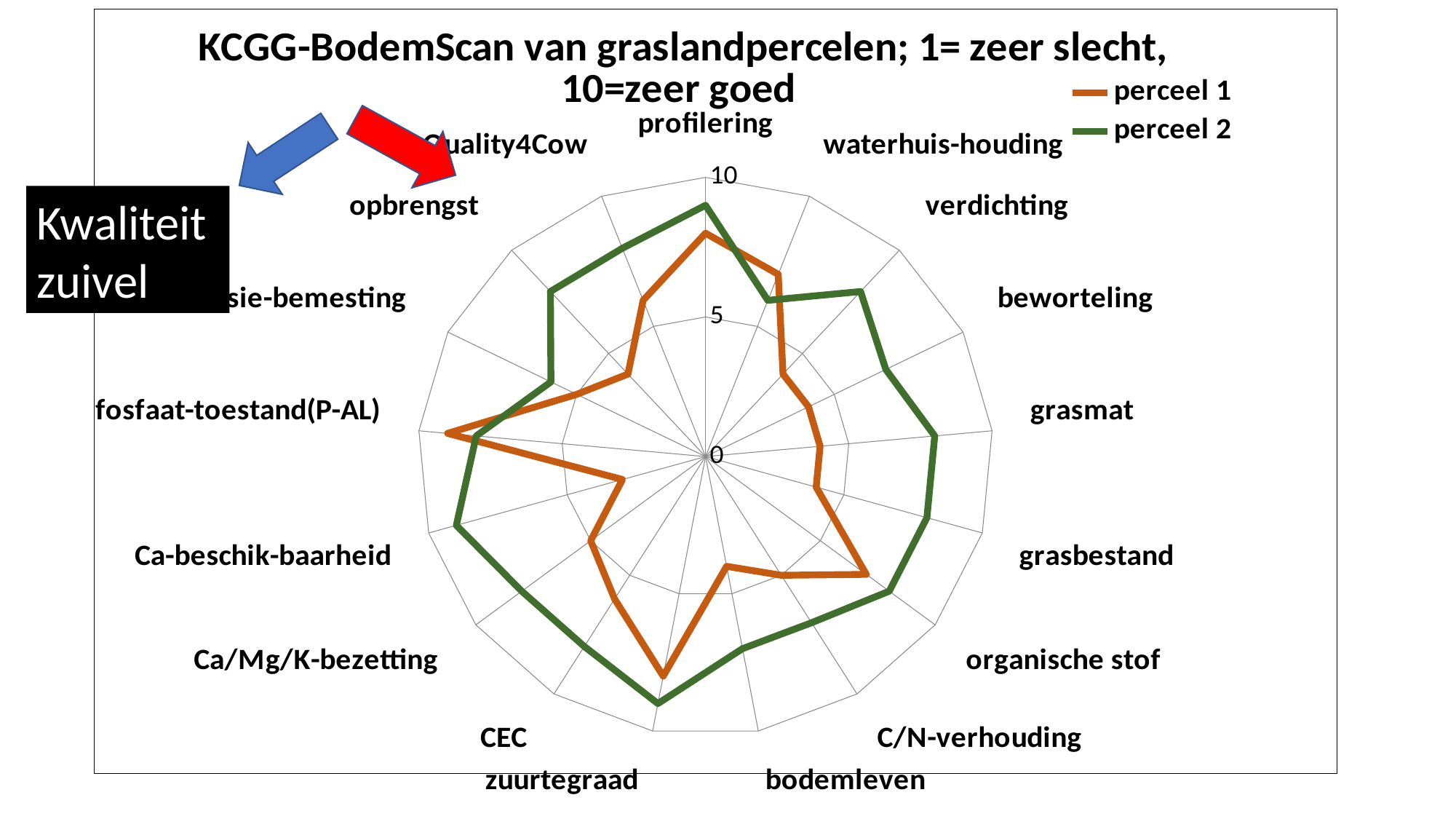
Is the value for fosfaat-toestand(P-AL) for perceel 1 greater or less than 5? greater How many series does the legend list? 2 Is the value for CEC for perceel 2 greater or less than 5? greater Which series has the higher value for grasmat, perceel 1 or perceel 2? perceel 2 Which series has the higher value for fosfaat-toestand(P-AL), perceel 1 or perceel 2? perceel 1 What is the maximum value shown on the chart's axis scale? 10 Which series has the higher value for Ca-beschik-baarheid, perceel 1 or perceel 2? perceel 2 Is the value for Ca-beschik-baarheid for perceel 1 greater or less than 5? less What kind of chart is shown on the slide? radar chart Which series are listed in the legend? perceel 1 and perceel 2